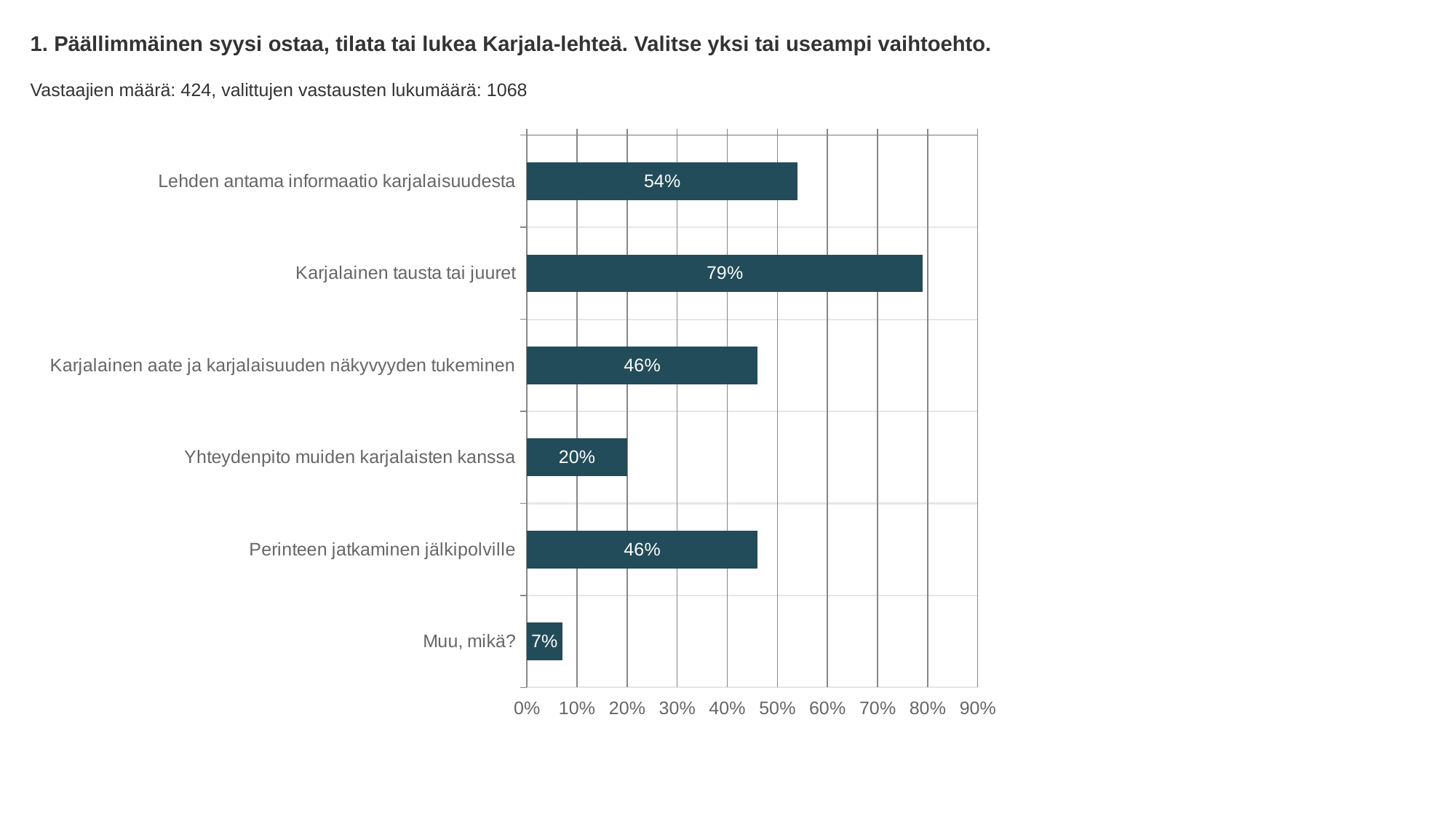
How many respondents (Vastaajien määrä) are stated on the slide? 424 Which is larger: the value for "Lehden antama informaatio karjalaisuudesta" or the value for "Perinteen jatkaminen jälkipolville"? Lehden antama informaatio karjalaisuudesta Which category has the highest value? Karjalainen tausta tai juuret What is the value for "Karjalainen tausta tai juuret"? 79% Is the value for "Karjalainen aate ja karjalaisuuden näkyvyyden tukeminen" greater or less than 50%? less What is the value for "Yhteydenpito muiden karjalaisten kanssa"? 20% What kind of chart is shown on the slide? bar chart Which category has the lowest value? Muu, mikä? How many categories are shown in the chart? 6 What is the difference between the values for "Karjalainen tausta tai juuret" and "Lehden antama informaatio karjalaisuudesta"? 25% What is the value for "Muu, mikä?"? 7% What is the value for "Lehden antama informaatio karjalaisuudesta"? 54%